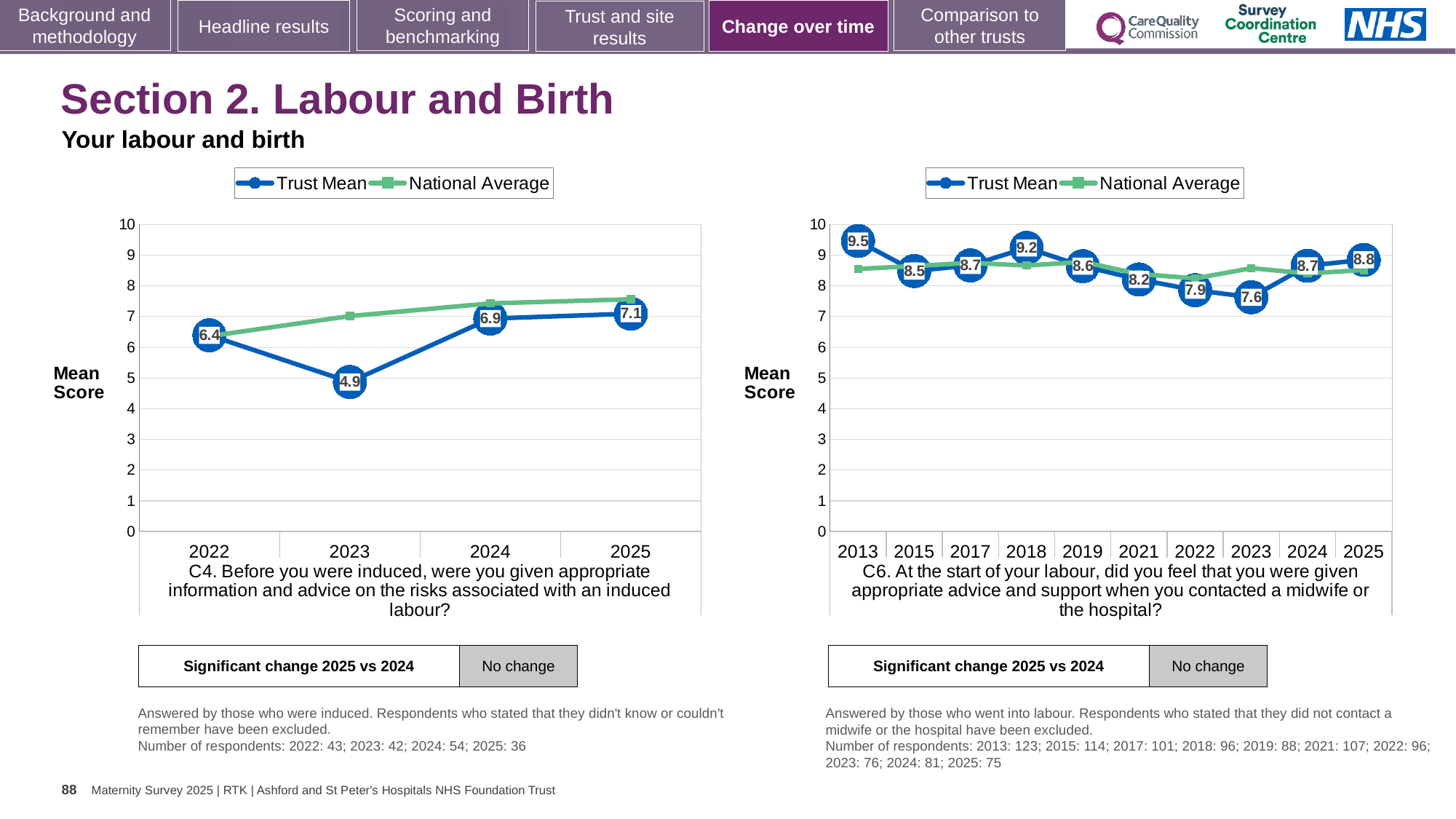
How many series does the legend of the right chart (C6) list? 2 In the left chart (C4), what is the Trust Mean score for 2023? 4.9 In the right chart (C6), what is the Trust Mean score for 2023? 7.6 In the left chart (C4), is the National Average for 2023 greater or less than 6? greater How many years are shown on the x axis of the right chart (C6)? 10 In the right chart (C6), what is the Trust Mean score for 2013? 9.5 In the right chart (C6), which year has the highest Trust Mean score? 2013 In the left chart (C4), which year has the lowest Trust Mean score? 2023 In the left chart (C4), what is the difference between the Trust Mean scores for 2024 and 2023? 2.0 In the right chart (C6), is the Trust Mean score for 2018 larger or smaller than the score for 2019? larger In the left chart (C4), what is the Trust Mean score for 2025? 7.1 How many years are shown on the x axis of the left chart (C4)? 4